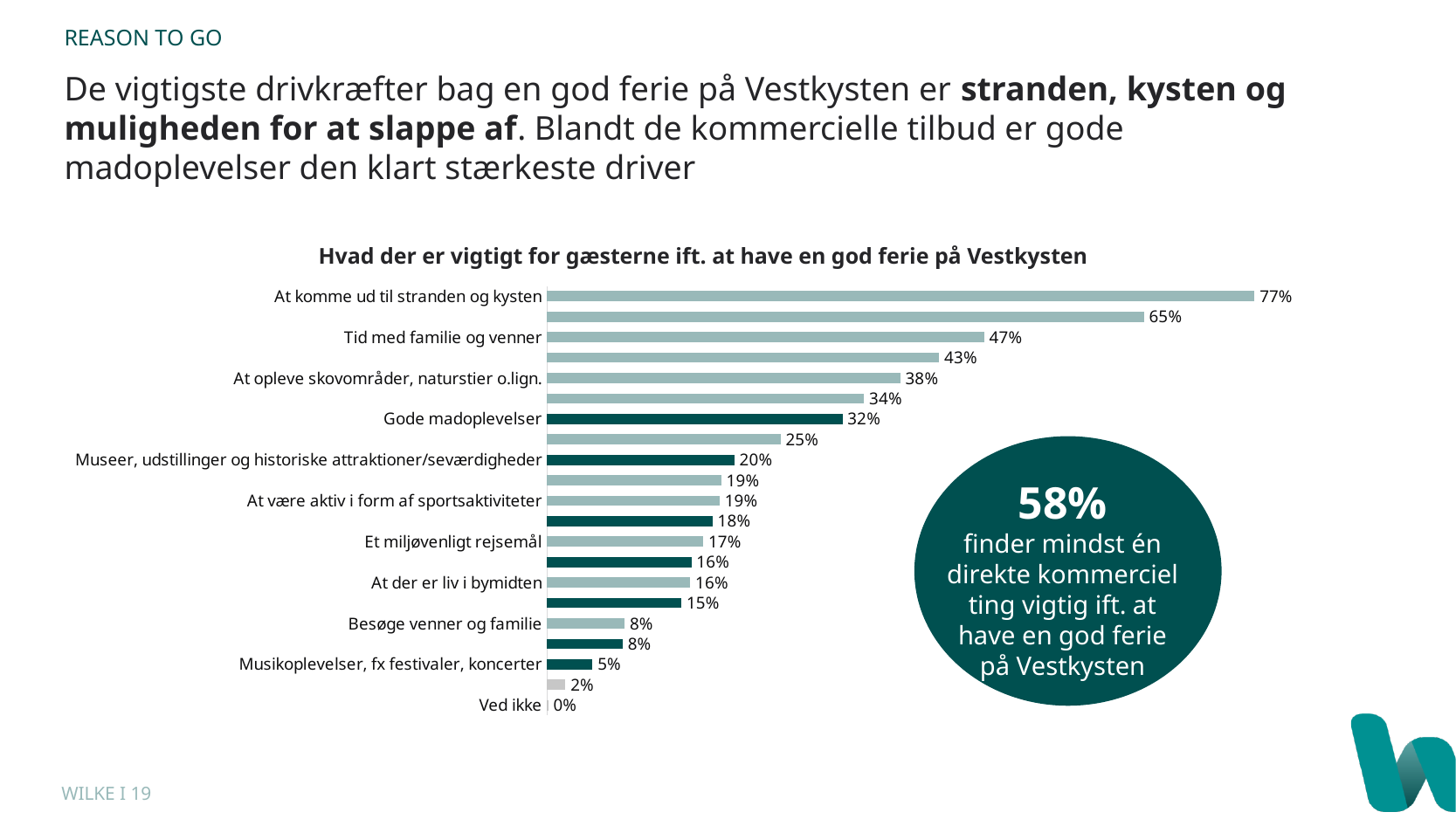
What is the difference between 'Museer, udstillinger og historiske attraktioner/seværdigheder' and 'Besøge venner og familie'? 12 percentage points What kind of chart is shown on the slide? Bar chart What is the value for 'Tid med familie og venner'? 47% What is the value for 'Musikoplevelser, fx festivaler, koncerter'? 5% Which labelled category has the lowest value? Ved ikke What is the value for 'Ved ikke'? 0% Which category has the highest value? At komme ud til stranden og kysten What is the value for 'At komme ud til stranden og kysten'? 77% Which is larger: 'Et miljøvenligt rejsemål' or 'At der er liv i bymidten'? Et miljøvenligt rejsemål What is the title of the chart? Hvad der er vigtigt for gæsterne ift. at have en god ferie på Vestkysten What is the difference between 'At komme ud til stranden og kysten' and 'Gode madoplevelser'? 45 percentage points What is the value for 'Gode madoplevelser'? 32%